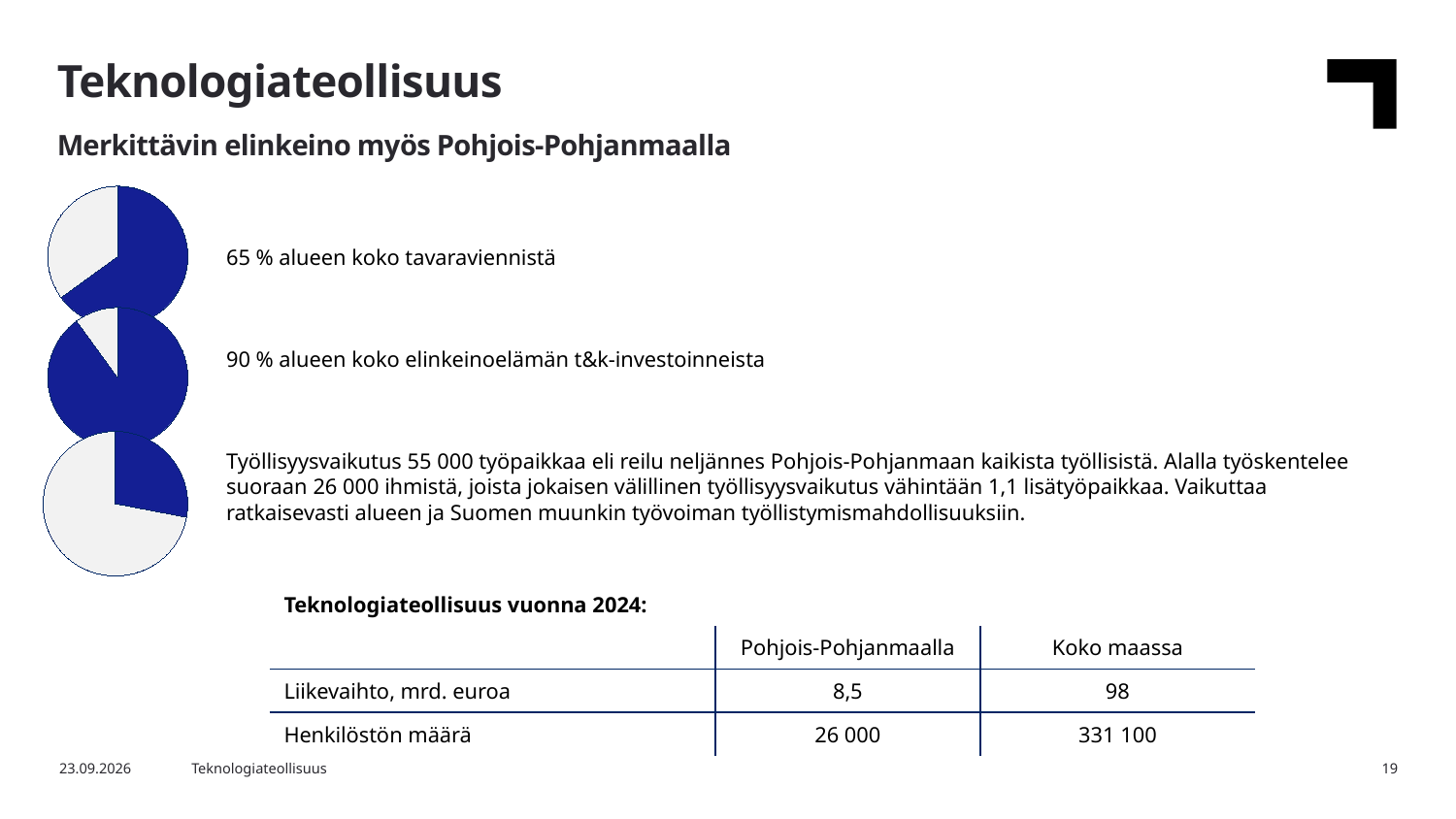
What kind of charts are shown on the left side of the slide? Pie charts How many slices does each pie chart have? 2 Which of the three pie charts has the smallest blue slice? The bottom one (työllisyysvaikutus) Which pie chart has the larger blue slice, the top one (tavaravienti) or the middle one (t&k-investoinnit)? The middle one (t&k-investoinnit) In the bottom pie chart, is the blue slice larger or smaller than half of the pie? Smaller What colour is the highlighted slice in each pie chart? Blue What text accompanies the top pie chart? 65 % alueen koko tavaraviennistä Which of the three pie charts has the largest blue slice? The middle one (t&k-investoinnit) In the top pie chart, what share of the region's total goods exports does the blue slice represent? 65 % How many pie charts are shown on the slide? 3 In the middle pie chart, what share of the region's business R&D investments does the blue slice represent? 90 %